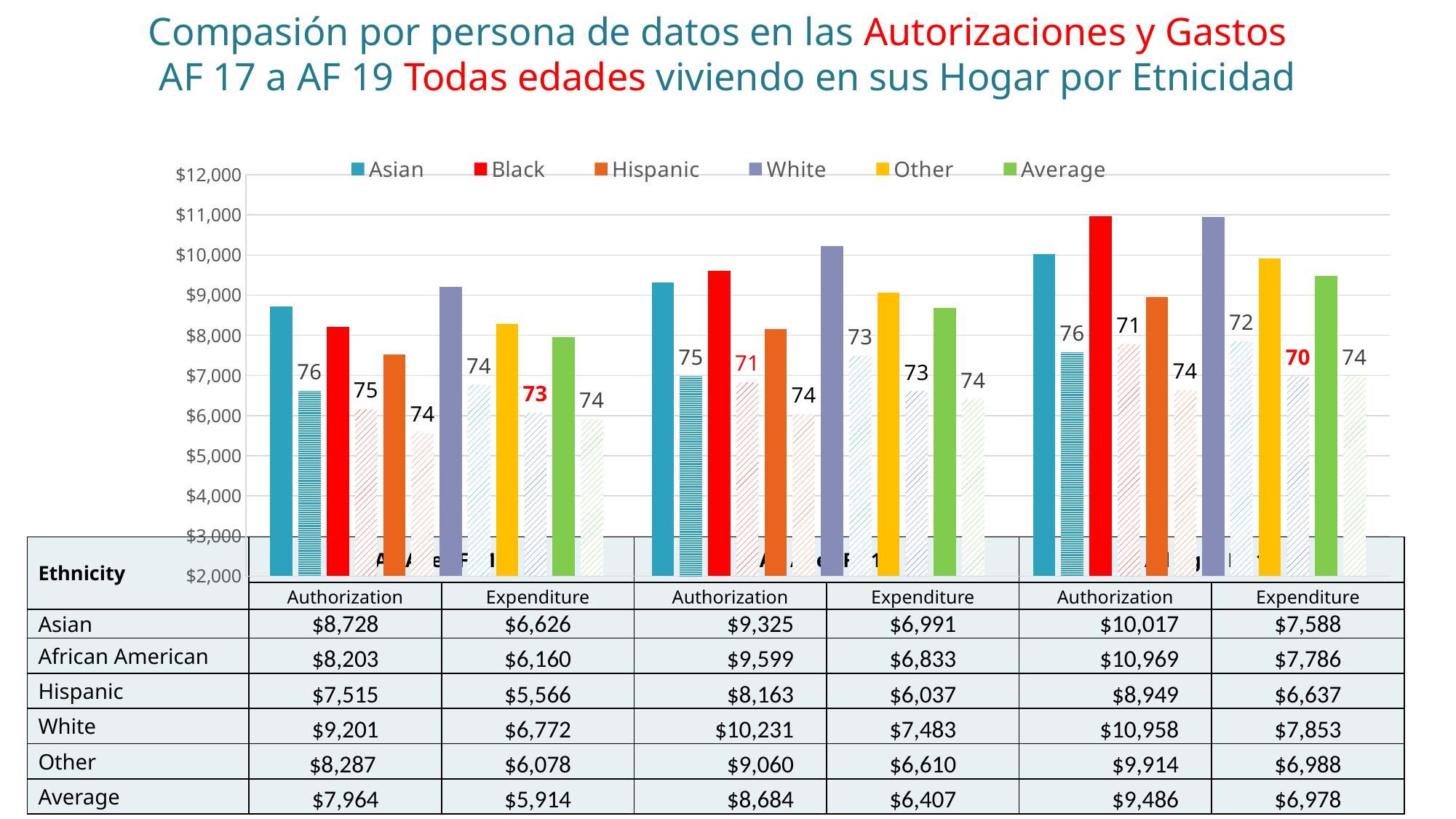
How many groups of bars are plotted along the x axis? 3 In the leftmost group, which is larger: the Asian Authorization value or the Black Authorization value? Asian In the middle group, which ethnicity has the highest Authorization value? White Does the Average Authorization value rise or fall from the leftmost group to the rightmost group? rise How many series does the chart legend list? 6 What is the Expenditure value for Hispanic in the middle group? $6,037 What kind of chart is shown on the slide? bar chart What is the Authorization value for Asian in the leftmost group? $8,728 What number is printed above the hatched Other bar in the rightmost group? 70 In the leftmost group, which ethnicity has the lowest Authorization value? Hispanic Is the White Authorization bar in the rightmost group greater or less than $10,000? greater In the leftmost group, what is the difference between the White Authorization value and the Asian Authorization value? $473